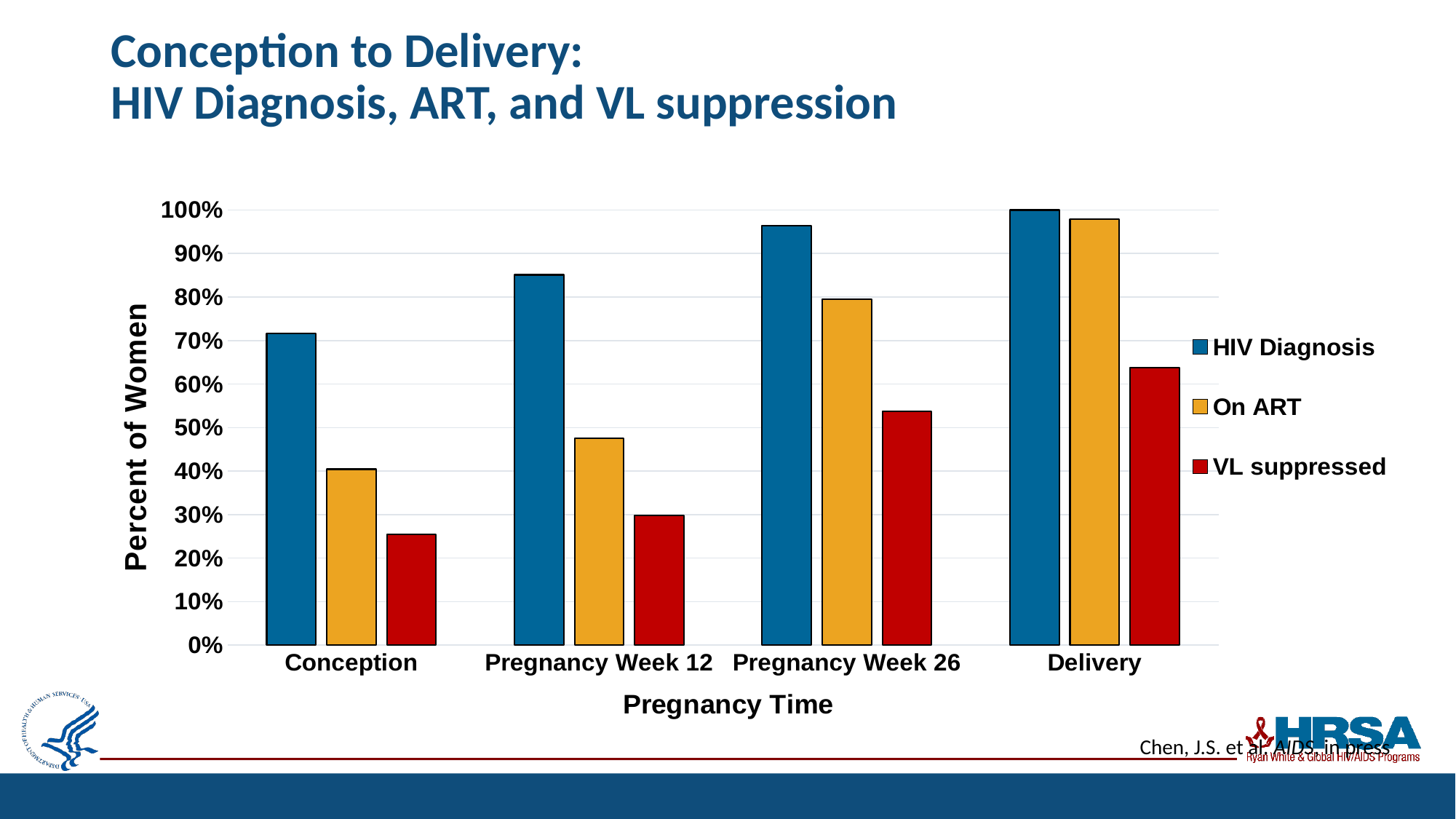
At which pregnancy time is the On ART value lowest? Conception How many pregnancy time categories are shown on the x axis? 4 Is the value for HIV Diagnosis at Pregnancy Week 12 greater or less than 80%? greater At Delivery, which is larger: On ART or VL suppressed? On ART How many series does the legend list? 3 What kind of chart is shown on the slide? bar chart Is the value for On ART at Pregnancy Week 26 greater or less than 70%? greater Is the value for VL suppressed at Conception greater or less than 30%? less Do the VL suppressed values rise or fall from Conception to Delivery? rise At which pregnancy time is the VL suppressed value highest? Delivery What is the value for HIV Diagnosis at Delivery? 100%